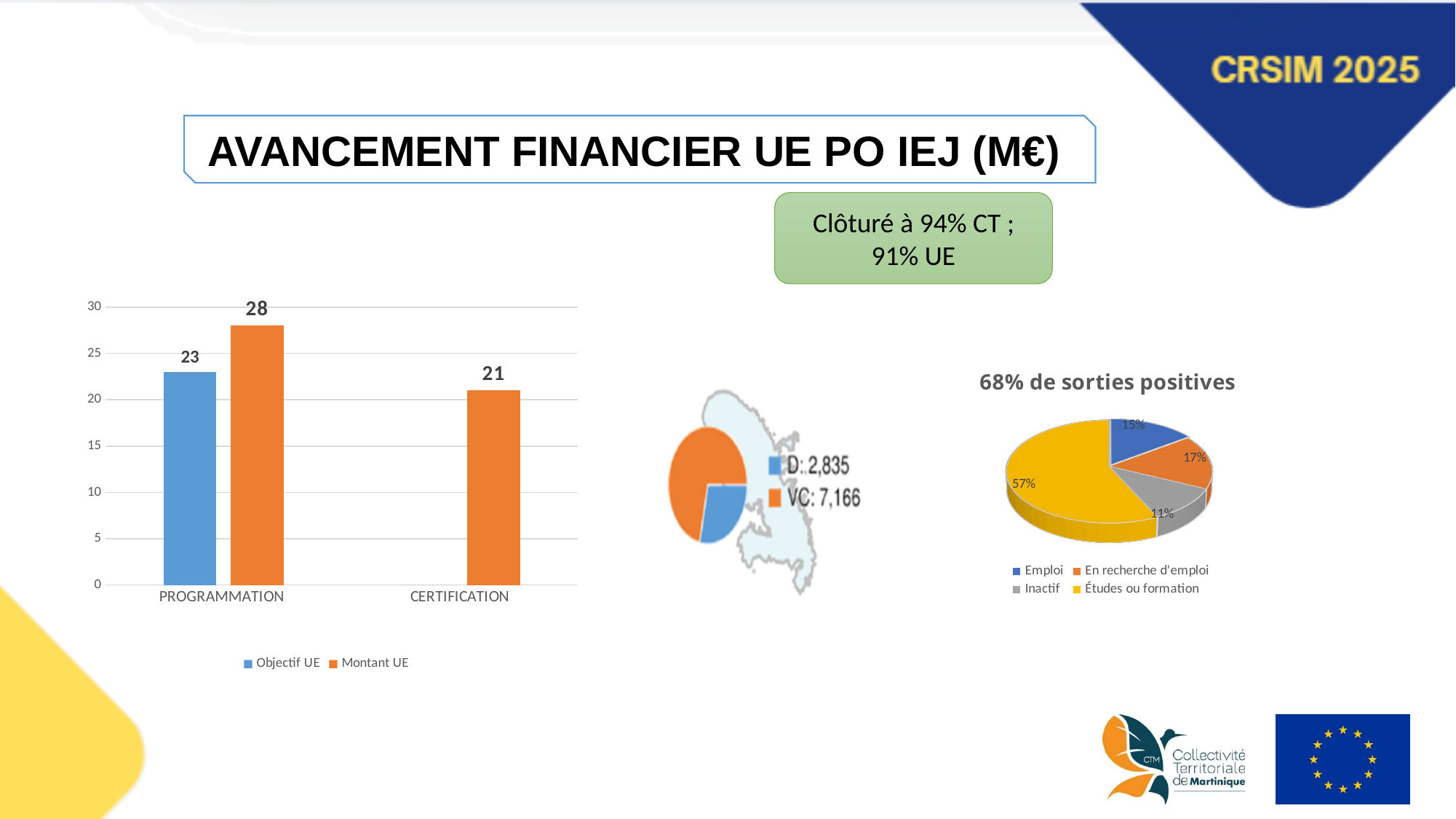
In the pie chart titled '68% de sorties positives', how many categories does the legend list? 4 In the pie chart titled '68% de sorties positives', what share is Études ou formation? 57% In the bar chart on the left, which is larger for PROGRAMMATION: Objectif UE or Montant UE? Montant UE In the bar chart on the left, what is the Montant UE value for CERTIFICATION? 21 In the bar chart on the left, what is the Montant UE value for PROGRAMMATION? 28 In the pie chart titled '68% de sorties positives', which category has the smallest share? Inactif In the bar chart on the left, how many series does the legend list? 2 In the bar chart on the left, what is the Objectif UE value for PROGRAMMATION? 23 What kind of chart is the chart on the left of the slide? Bar chart In the pie chart titled '68% de sorties positives', what share is Emploi? 15% In the bar chart on the left, what is the difference between the Montant UE and Objectif UE values for PROGRAMMATION? 5 In the small pie chart over the map in the middle of the slide, what is the value for VC? 7,166